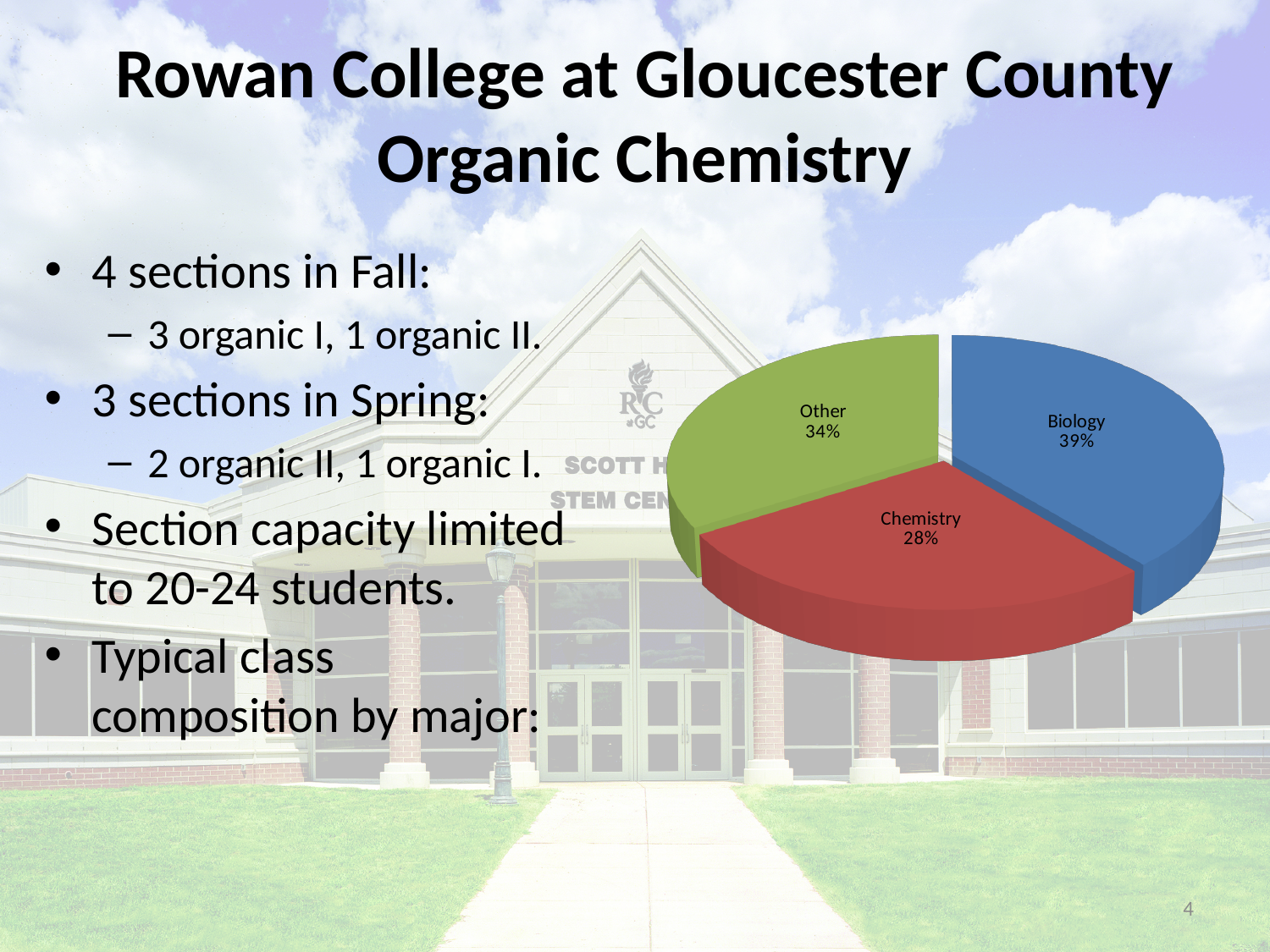
Which slice is larger, Biology or Other? Biology Which slice is larger, Other or Chemistry? Other What share of the pie chart is Other? 34% What share of the pie chart is Chemistry? 28% What share of the pie chart is Biology? 39% Which major has the smallest slice of the pie chart? Chemistry What is the difference in percentage points between the Other and Chemistry slices? 6 What kind of chart is shown on the slide? Pie chart What is the difference in percentage points between the Biology and Chemistry slices? 11 Which major has the largest slice of the pie chart? Biology How many slices does the pie chart have? 3 What colour is the Chemistry slice of the pie chart? Red